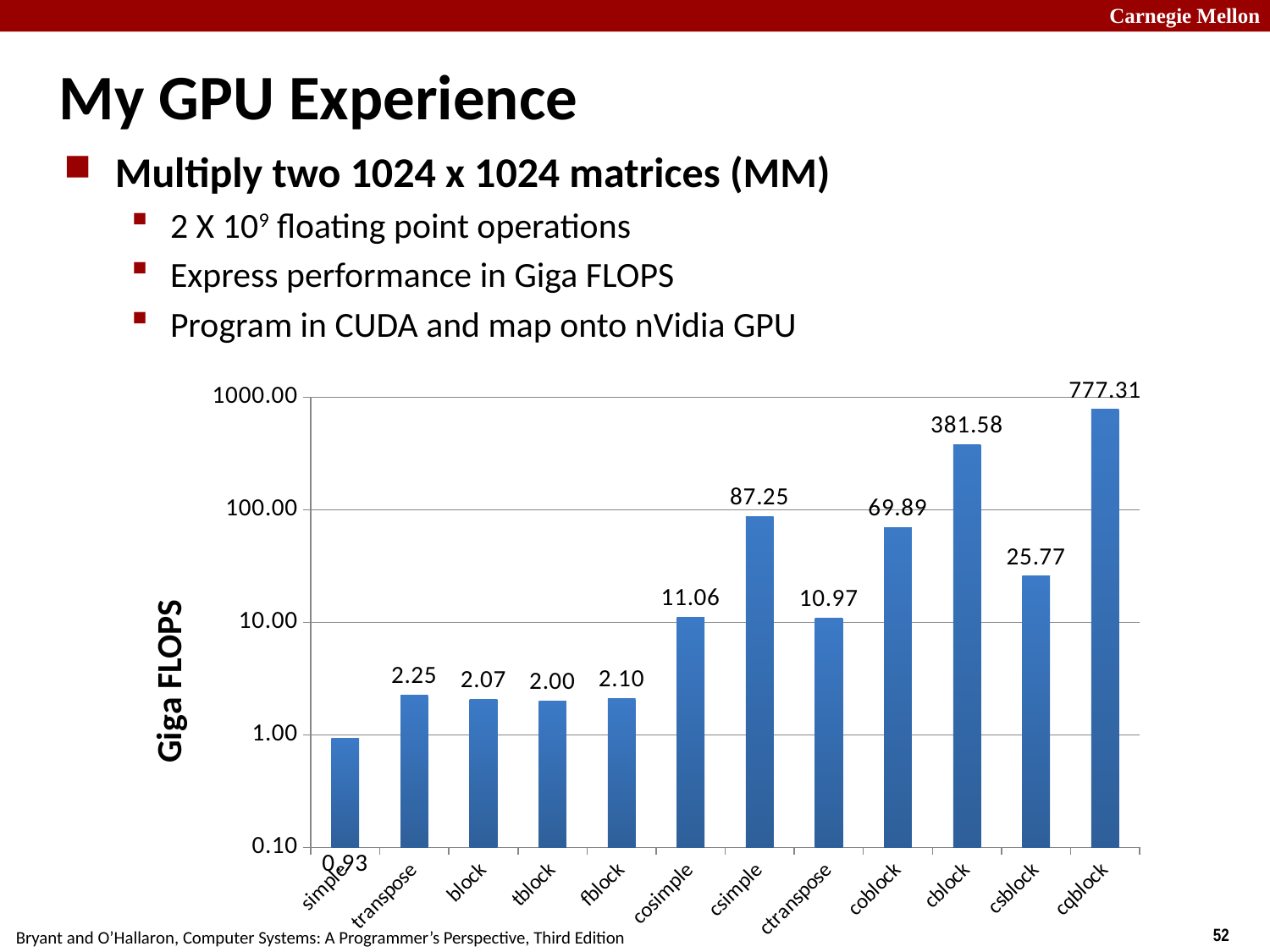
Which category has the lowest Giga FLOPS value? simple How many categories are shown on the x axis of the chart? 12 Which category has the highest Giga FLOPS value? cqblock What is the Giga FLOPS value for cqblock? 777.31 What kind of chart is shown on the slide? bar chart What is the Giga FLOPS value for csimple? 87.25 What is the difference in Giga FLOPS between cqblock and cblock? 395.73 Which has a higher Giga FLOPS value, coblock or csblock? coblock What is the Giga FLOPS value for tblock? 2.00 What is the label of the y axis of the chart? Giga FLOPS What is the Giga FLOPS value for ctranspose? 10.97 Is the value for cblock greater or less than 100.00? greater